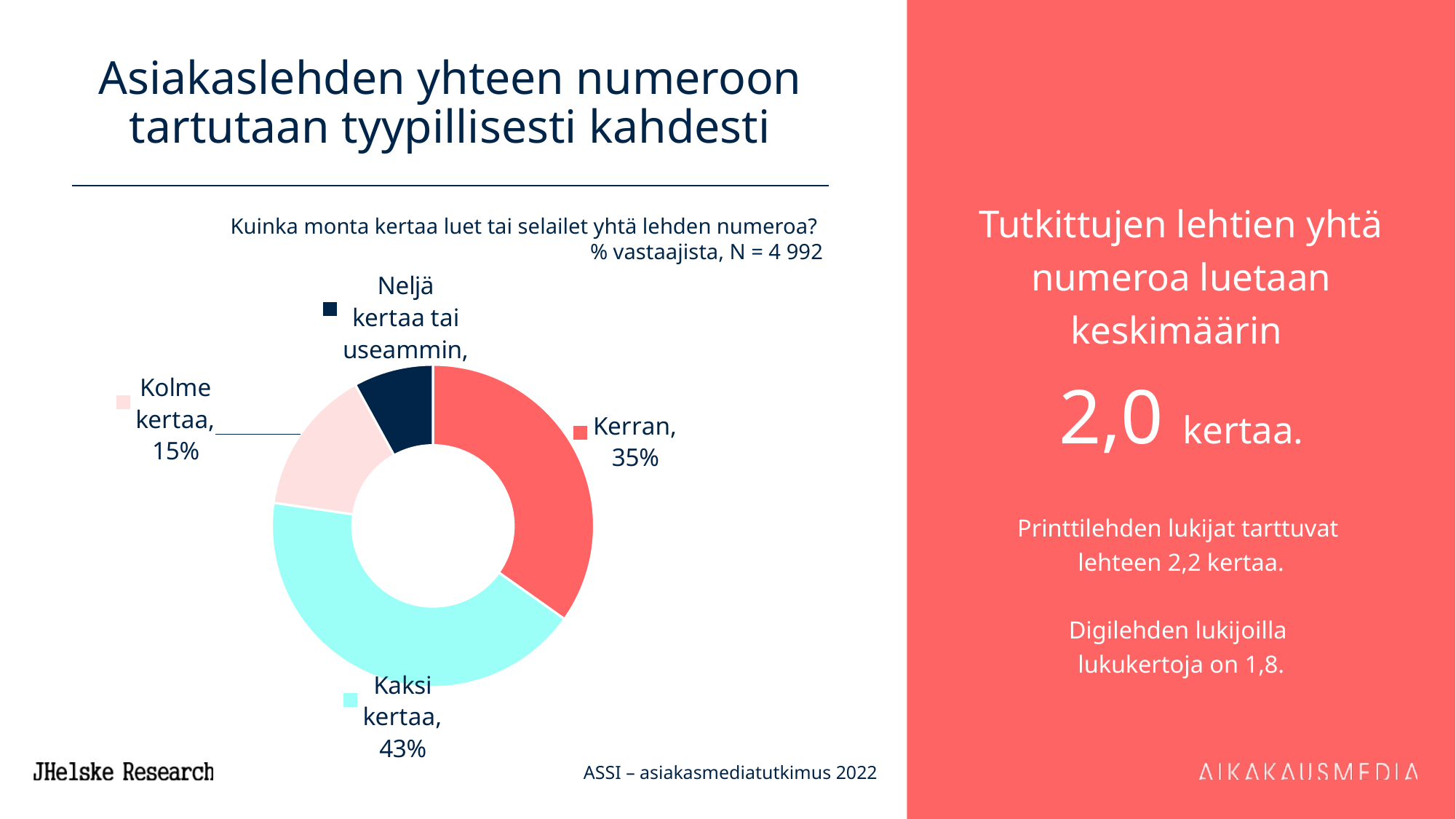
Which category has the largest share of the chart? Kaksi kertaa What percentage of respondents answered "Kaksi kertaa"? 43% What is the number of respondents (N) stated above the chart? 4 992 What kind of chart is shown on the slide? Donut (pie) chart Which is larger, the share for "Kerran" or the share for "Kaksi kertaa"? Kaksi kertaa Which category has the smallest share of the chart? Neljä kertaa tai useammin Which is larger, the share for "Kolme kertaa" or the share for "Neljä kertaa tai useammin"? Kolme kertaa What percentage of respondents answered "Kolme kertaa"? 15% How many categories (slices) does the chart have? 4 What is the difference in percentage points between "Kerran" and "Kolme kertaa"? 20 What percentage of respondents answered "Kerran"? 35% What is the difference in percentage points between "Kaksi kertaa" and "Kerran"? 8